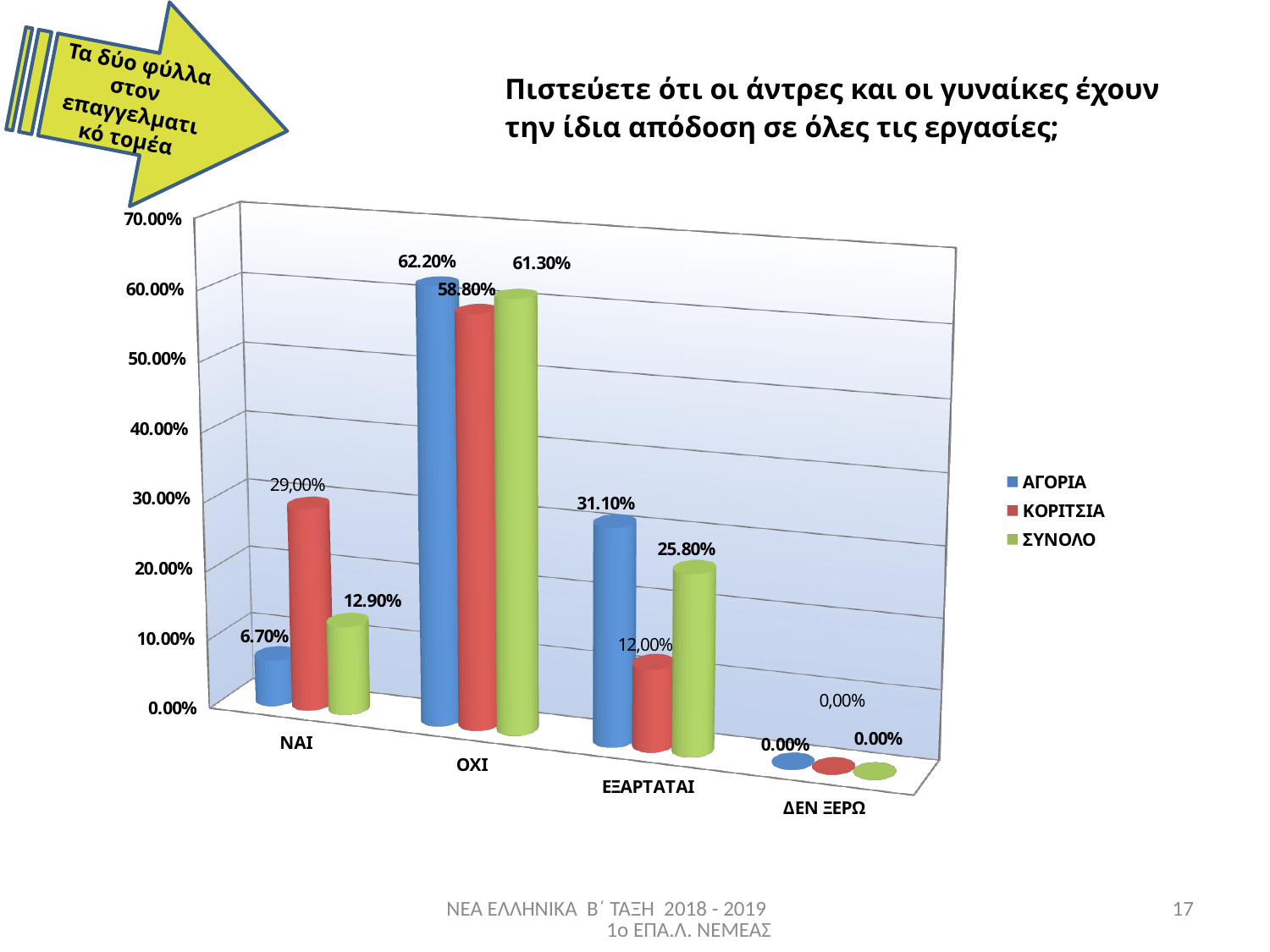
How many series does the legend list? 3 Which category has the highest value for ΣΥΝΟΛΟ? ΟΧΙ What is the value for ΚΟΡΙΤΣΙΑ in the ΝΑΙ category? 29,00% What kind of chart is shown on the slide? Bar chart In the ΝΑΙ category, which is larger: the value for ΑΓΟΡΙΑ or the value for ΚΟΡΙΤΣΙΑ? ΚΟΡΙΤΣΙΑ How many categories are shown on the x axis? 4 What is the value for ΑΓΟΡΙΑ in the ΟΧΙ category? 62.20% What is the difference between the ΑΓΟΡΙΑ and ΚΟΡΙΤΣΙΑ values in the ΟΧΙ category? 3.40% What is the value for ΚΟΡΙΤΣΙΑ in the ΕΞΑΡΤΑΤΑΙ category? 12,00% Which category has the lowest value for ΑΓΟΡΙΑ? ΔΕΝ ΞΕΡΩ What is the value for ΣΥΝΟΛΟ in the ΕΞΑΡΤΑΤΑΙ category? 25.80% What is the difference between the ΑΓΟΡΙΑ and ΣΥΝΟΛΟ values in the ΕΞΑΡΤΑΤΑΙ category? 5.30%